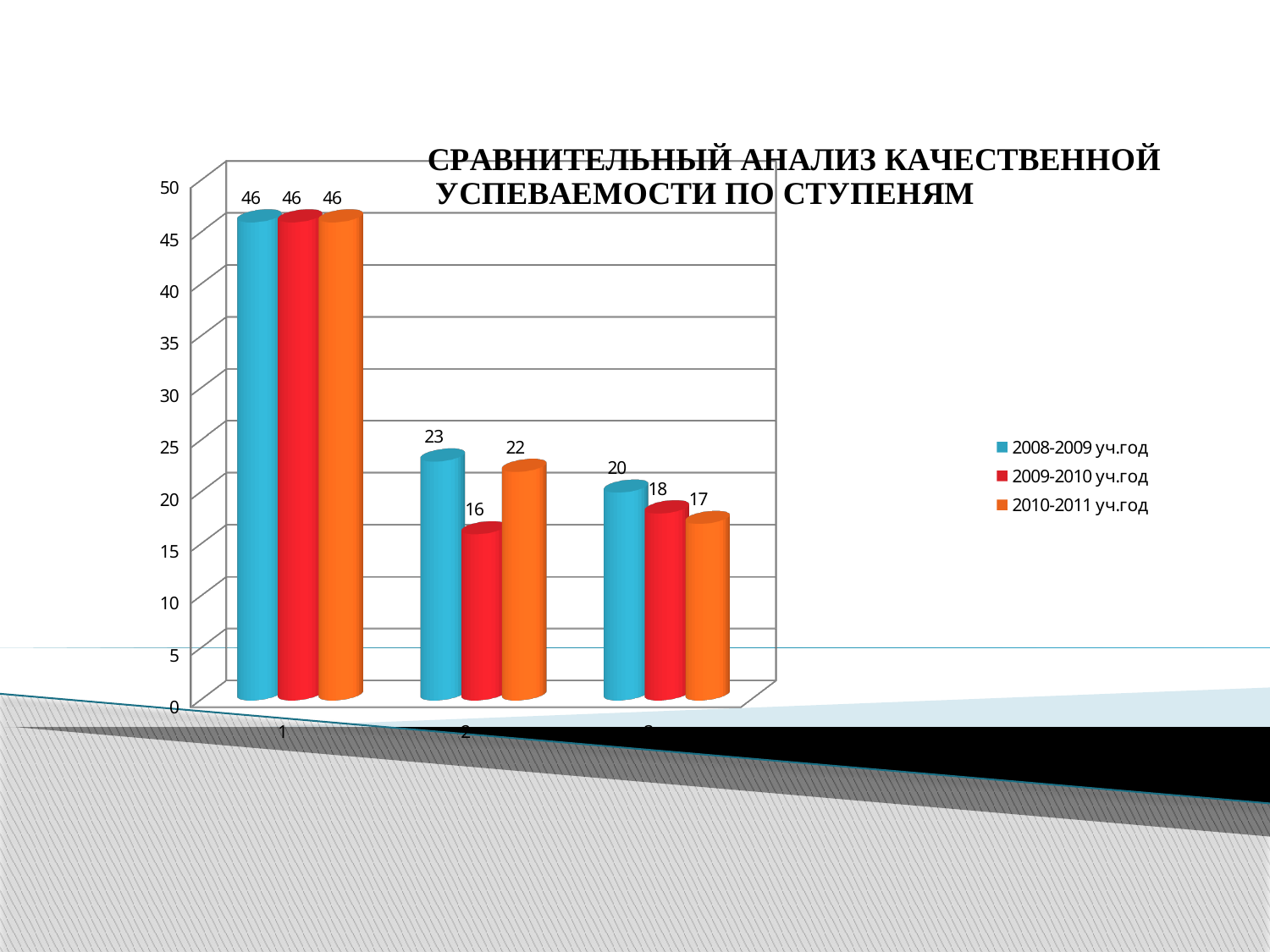
How many category groups of bars are plotted? 3 What is the value for the 2010-2011 уч.год series in the second category group? 22 What is the value for the 2009-2010 уч.год series in the second category group? 16 Which series is shown in red in the legend? 2009-2010 уч.год How many series does the legend list? 3 Within the second category group, which series has the lowest value? 2009-2010 уч.год What type of chart is shown on the slide? bar chart What is the difference between the 2008-2009 уч.год and 2009-2010 уч.год values in the second category group? 7 Within the third category group, which series has the highest value? 2008-2009 уч.год In the third category group, which is larger: the 2009-2010 уч.год value or the 2010-2011 уч.год value? 2009-2010 уч.год What is the value for the 2008-2009 уч.год series in the first category group? 46 What is the value for the 2010-2011 уч.год series in the third category group? 17